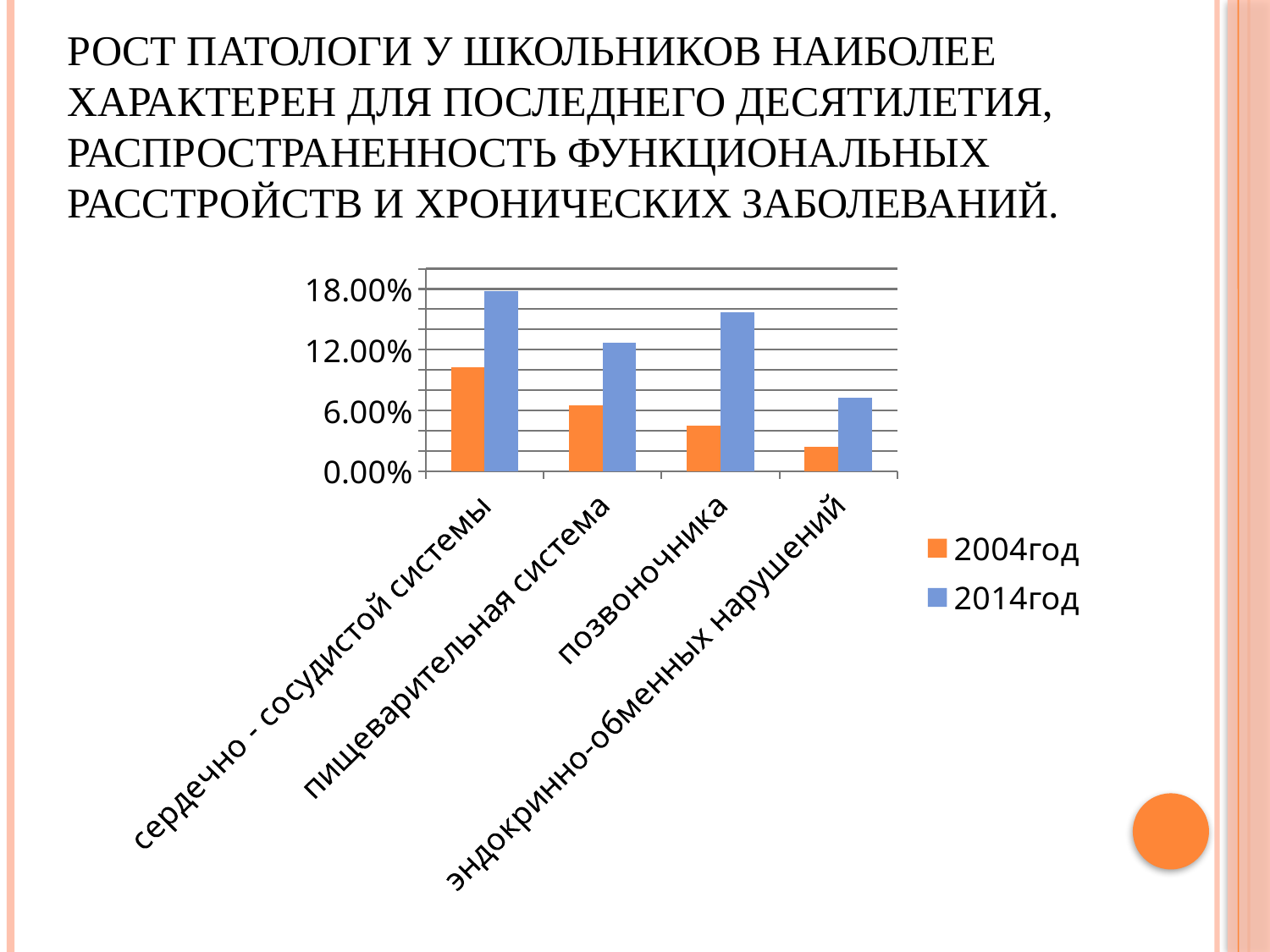
What kind of chart is shown on the slide? bar chart For позвоночника, which series has the larger value, 2004год or 2014год? 2014год Is the 2014год value for сердечно - сосудистой системы greater or less than 12.00%? greater Which series is shown in orange in the legend? 2004год Which category has the lowest value for 2004год? эндокринно-обменных нарушений How many categories are shown on the x axis? 4 Is the 2004год value for позвоночника greater or less than 6.00%? less Is the 2014год value for эндокринно-обменных нарушений greater or less than 6.00%? greater How many series does the legend list? 2 Which category has the lowest value for 2014год? эндокринно-обменных нарушений Which category has the highest value for 2014год? сердечно - сосудистой системы